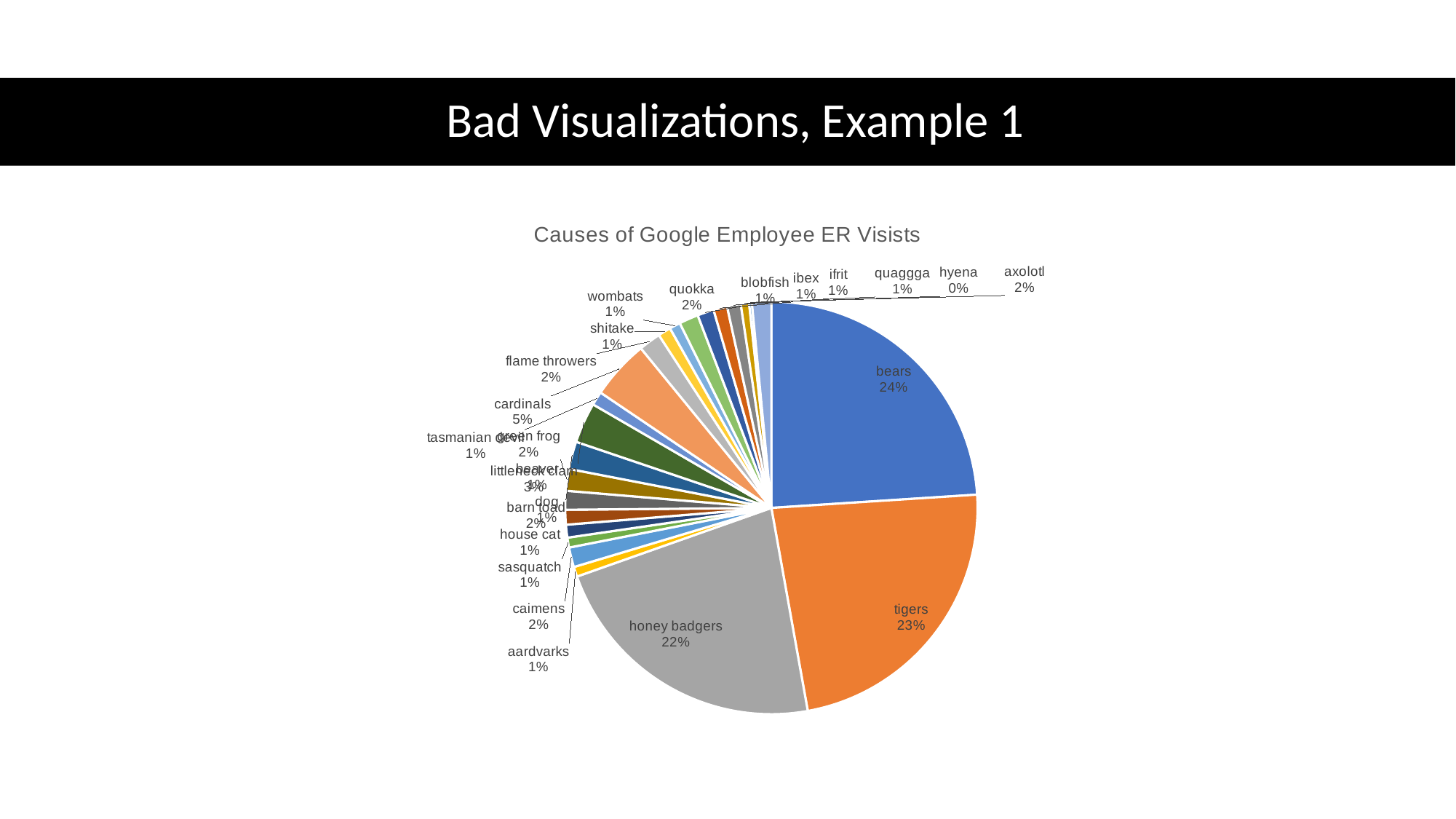
What is the difference in percentage points between bears and tigers? 1% What share of the pie do bears account for? 24% What is the title of the chart? Causes of Google Employee ER Visists What percentage is shown for cardinals? 5% What percentage is shown for flame throwers? 2% What percentage is shown for honey badgers? 22% Which is larger, the share for honey badgers or the share for cardinals? honey badgers What percentage is shown for tigers? 23% What type of chart is shown on the slide? pie chart Which category has the largest slice of the pie? bears Which category has the smallest slice of the pie? hyena What percentage is shown for hyena? 0%